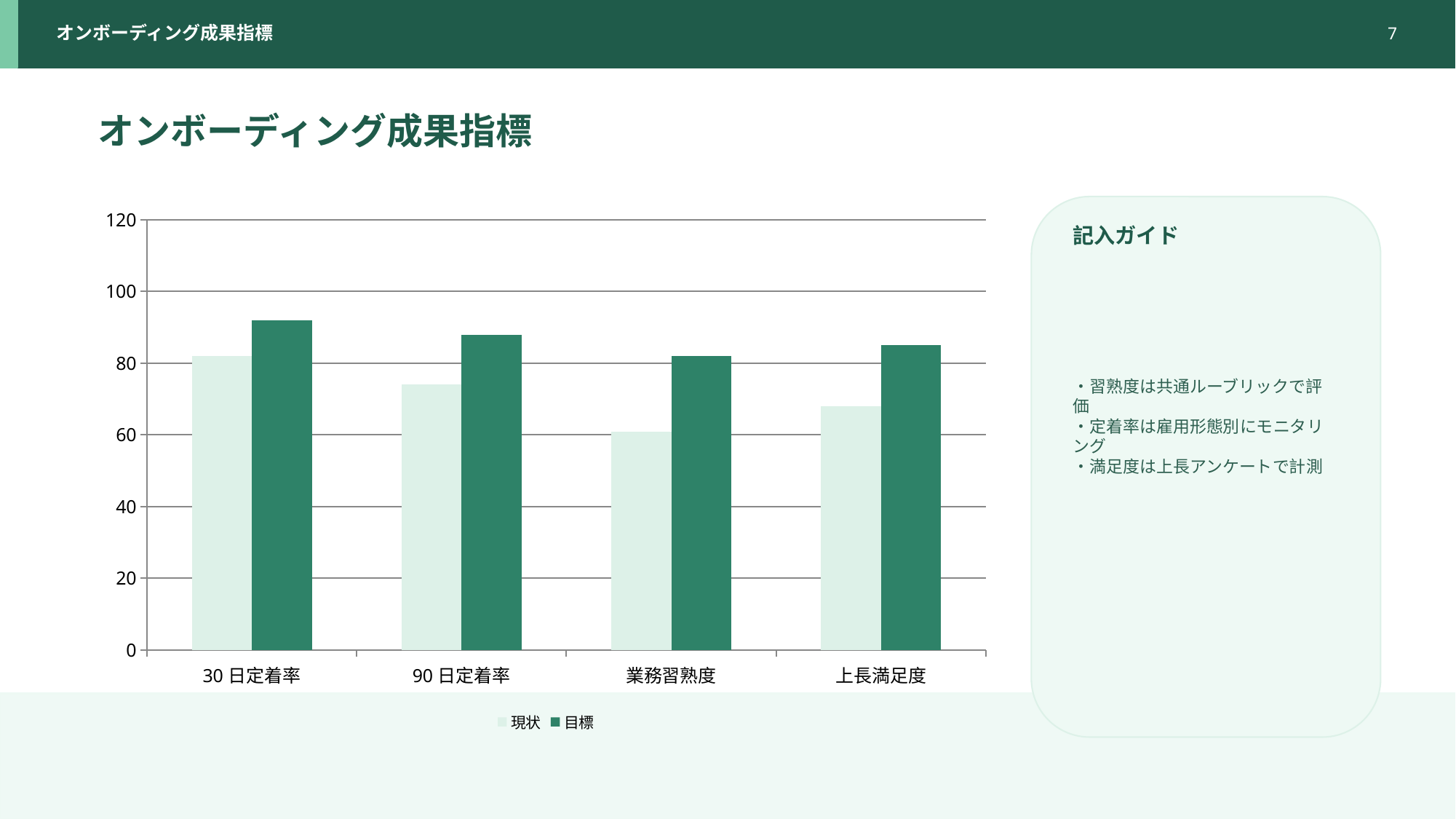
How many categories are shown on the x axis of the chart? 4 How many series does the chart's legend list? 2 Is the 目標 value for 上長満足度 greater or less than 80? greater Is the 現状 value for 90 日定着率 greater or less than 80? less Which category has the highest 現状 value? 30 日定着率 Is the 目標 value for 30 日定着率 greater or less than 100? less What kind of chart is shown on the slide? bar chart For 業務習熟度, which is larger, the 現状 value or the 目標 value? 目標 Which category has the lowest 現状 value? 業務習熟度 What are the two series named in the chart's legend? 現状 and 目標 Which is larger, the 現状 value for 30 日定着率 or the 現状 value for 業務習熟度? 30 日定着率